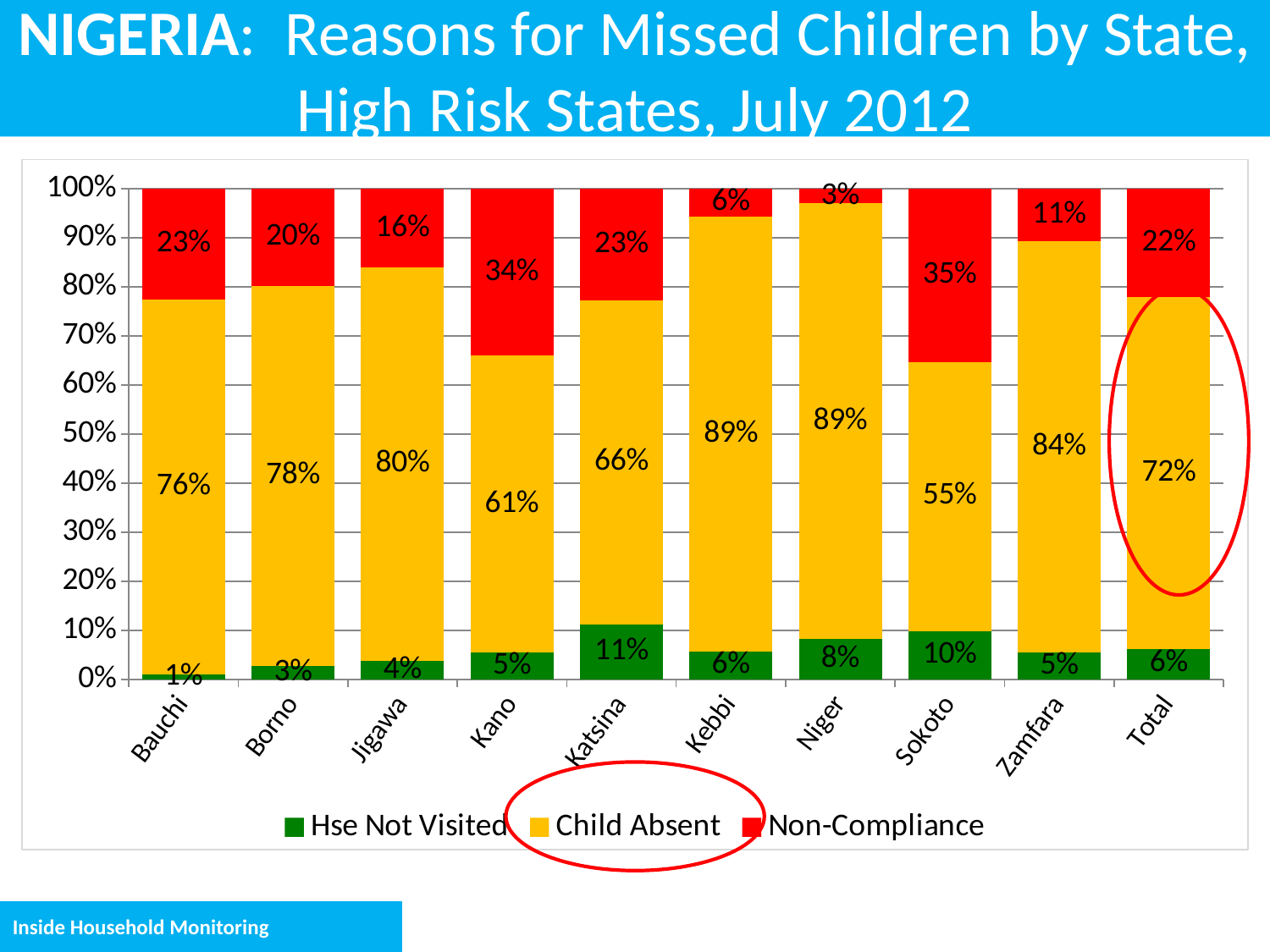
Which legend entry is circled in red on the slide? Child Absent Which state has the lowest Non-Compliance percentage? Niger How many percentage points higher is the Non-Compliance share in Kano than in Jigawa? 18 percentage points What is the Child Absent percentage for the Total bar? 72% How many series does the legend list? 3 Which state has the highest Hse Not Visited percentage? Katsina Which has a larger Child Absent percentage, Zamfara or Borno? Zamfara Which state has the lowest Child Absent percentage? Sokoto How many bars (states plus Total) are shown on the x axis? 10 What is the Hse Not Visited percentage for Sokoto? 10% What kind of chart is shown on the slide? Stacked bar chart What percentage of missed children in Kano were missed due to Non-Compliance? 34%